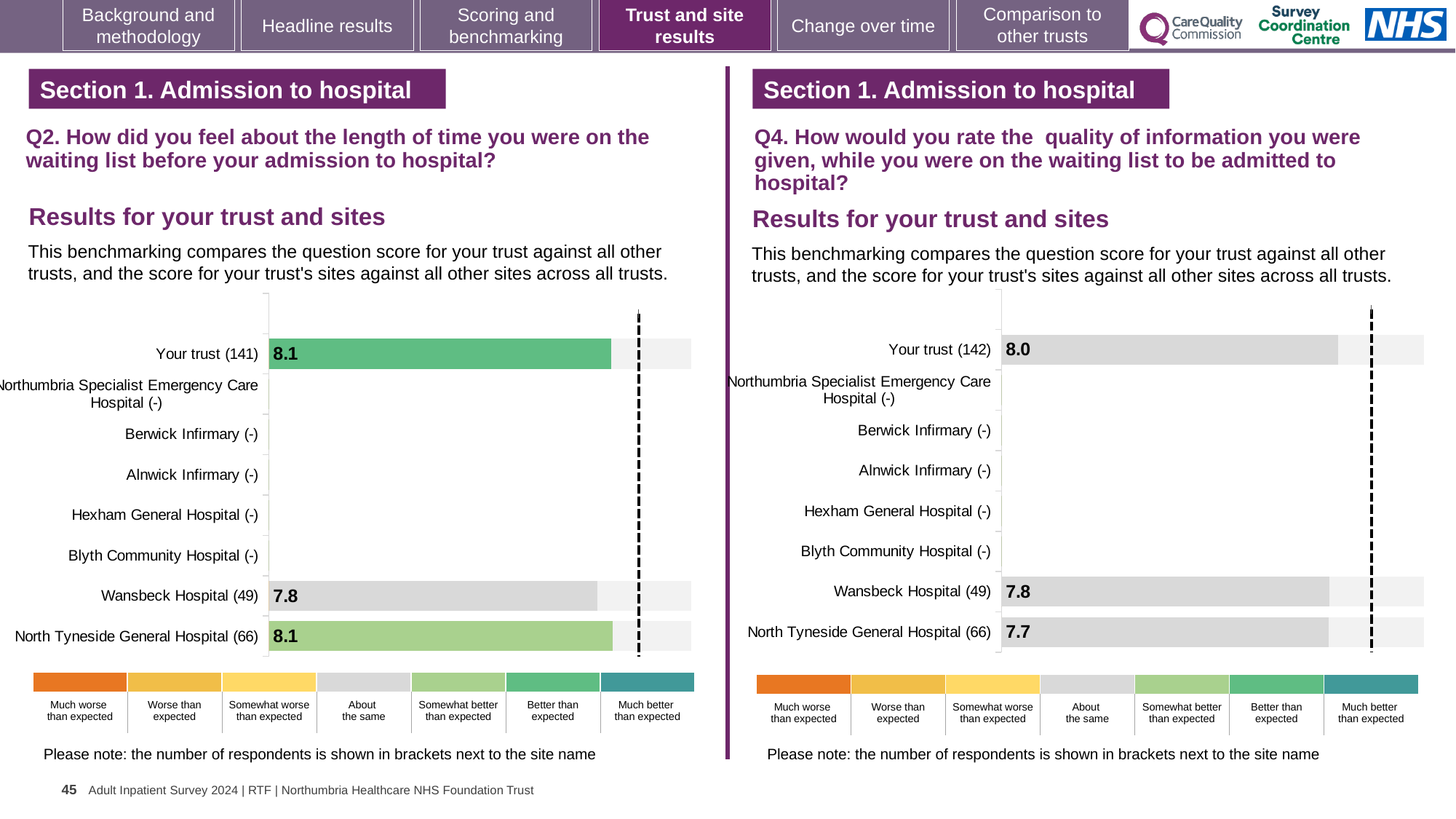
On the Q4 chart (right), what is the difference between the score for Your trust (142) and North Tyneside General Hospital (66)? 0.3 What kind of chart is used on the Q2 chart (left)? Bar chart On the Q4 chart (right), what is the score for North Tyneside General Hospital (66)? 7.7 On the Q4 chart (right), what is the score for Your trust (142)? 8.0 On the Q2 chart (left), what is the score for Your trust (141)? 8.1 On the Q2 chart (left), what is the difference between the score for Your trust (141) and Wansbeck Hospital (49)? 0.3 On the Q4 chart (right), which has the larger score: Wansbeck Hospital (49) or North Tyneside General Hospital (66)? Wansbeck Hospital (49) On the Q2 chart (left), what is the score for Wansbeck Hospital (49)? 7.8 On the Q4 chart (right), which row has the highest printed score? Your trust (142) How many category rows are listed on the Q2 chart (left)? 8 On the Q2 chart (left), what is the score for North Tyneside General Hospital (66)? 8.1 On the Q4 chart (right), which site or trust row has the lowest printed score? North Tyneside General Hospital (66)